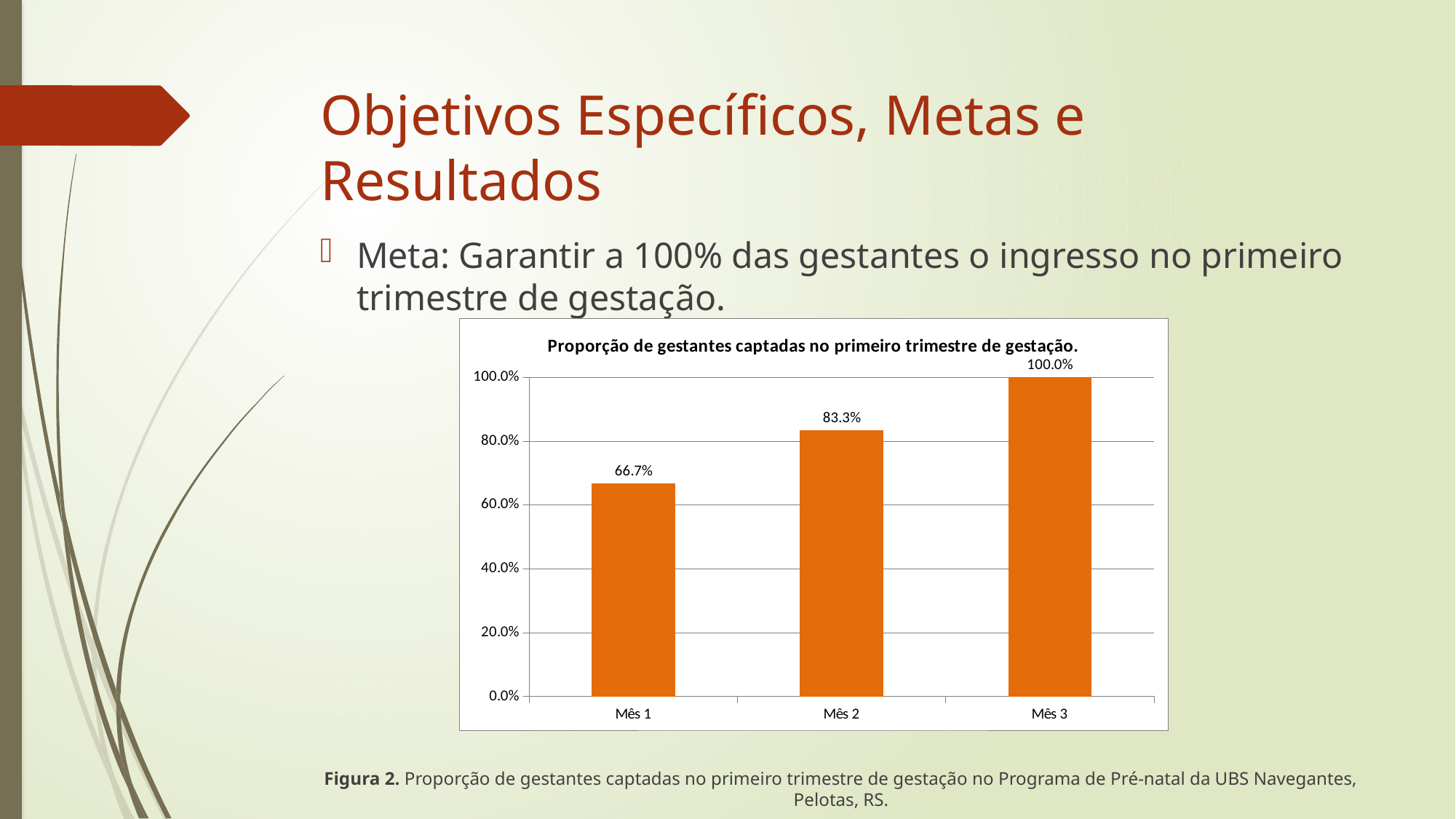
What is the value for Mês 2? 83.3% What is the value for Mês 1? 66.7% What is the value for Mês 3? 100.0% Which month has the lowest proportion? Mês 1 What is the difference between the values for Mês 3 and Mês 1? 33.3% Which month has the highest proportion? Mês 3 Is the value for Mês 2 greater or less than 80.0%? greater Which is larger, the value for Mês 2 or the value for Mês 1? Mês 2 What is the difference between the values for Mês 2 and Mês 1? 16.6% What kind of chart is shown on the slide? bar chart Do the values rise or fall from Mês 1 to Mês 3? rise How many months are shown on the x axis? 3